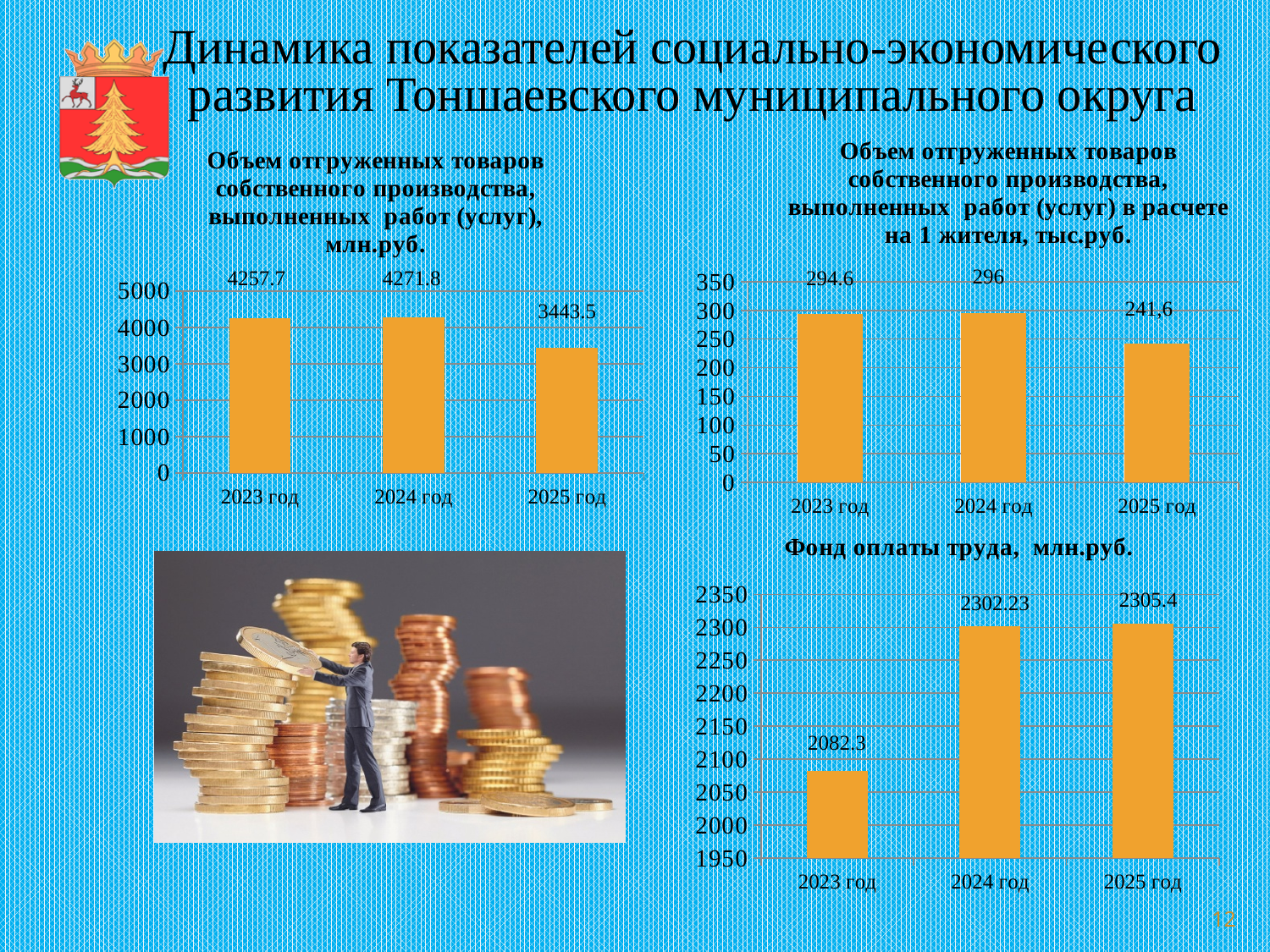
How many years are shown in the chart 'Фонд оплаты труда, млн.руб.'? 3 In the chart 'Объем отгруженных товаров ... в расчете на 1 жителя, тыс.руб.', which year has the lowest value? 2025 год In the chart 'Фонд оплаты труда, млн.руб.', what is the difference between the values for 2025 год and 2023 год? 223.1 In the chart 'Объем отгруженных товаров ... в расчете на 1 жителя, тыс.руб.', what is the value for 2024 год? 296 In the chart 'Объем отгруженных товаров собственного производства, выполненных работ (услуг), млн.руб.', what is the difference between the values for 2024 год and 2025 год? 828.3 In the chart 'Фонд оплаты труда, млн.руб.', what is the value for 2023 год? 2082.3 In the chart 'Фонд оплаты труда, млн.руб.', is the value for 2023 год greater or less than 2100? less In the chart 'Объем отгруженных товаров собственного производства, выполненных работ (услуг), млн.руб.', what is the value for 2023 год? 4257.7 In the chart 'Объем отгруженных товаров ... в расчете на 1 жителя, тыс.руб.', what is the value for 2025 год? 241,6 In the chart 'Объем отгруженных товаров собственного производства, выполненных работ (услуг), млн.руб.', what is the value for 2025 год? 3443.5 In the chart 'Объем отгруженных товаров собственного производства, выполненных работ (услуг), млн.руб.', which year has the lowest value? 2025 год In the chart 'Фонд оплаты труда, млн.руб.', what is the value for 2024 год? 2302.23